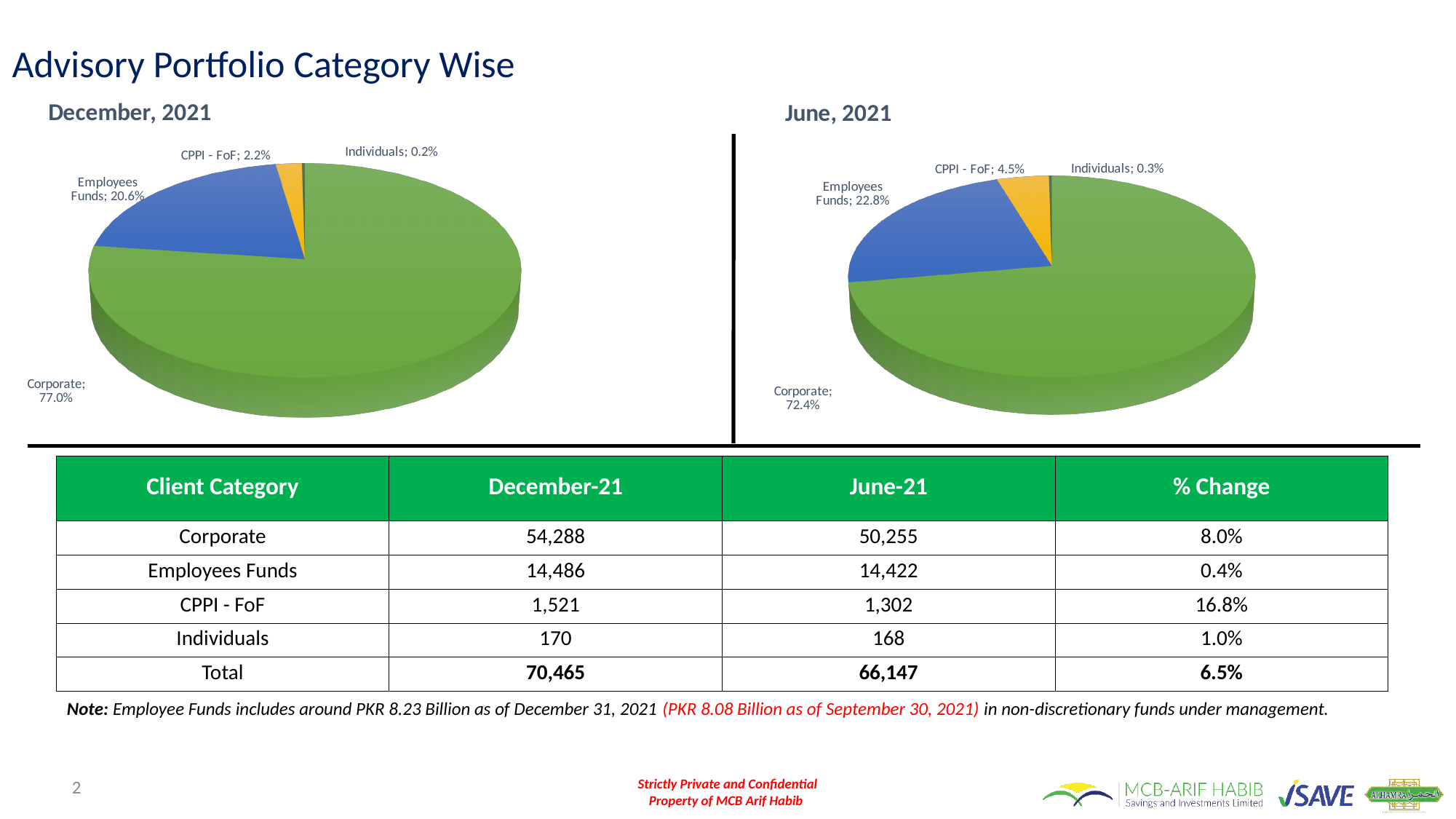
In the December, 2021 pie chart, what is the difference in percentage points between Corporate and Employees Funds? 56.4 percentage points In the December, 2021 pie chart, what share does Corporate hold? 77.0% How many categories are shown in the December, 2021 pie chart? 4 In the June, 2021 pie chart, what is the value shown for Individuals? 0.3% What type of chart is used for June, 2021? Pie chart In the December, 2021 pie chart, what colour is the Employees Funds slice? Blue In the December, 2021 pie chart, what is the value shown for CPPI - FoF? 2.2% In the June, 2021 pie chart, what share does Employees Funds hold? 22.8% In the June, 2021 pie chart, what is the difference in percentage points between CPPI - FoF and Individuals? 4.2 percentage points In the December, 2021 pie chart, which category has the largest slice? Corporate Is the CPPI - FoF share larger in the December, 2021 chart or the June, 2021 chart? June, 2021 In the June, 2021 pie chart, which category has the smallest slice? Individuals